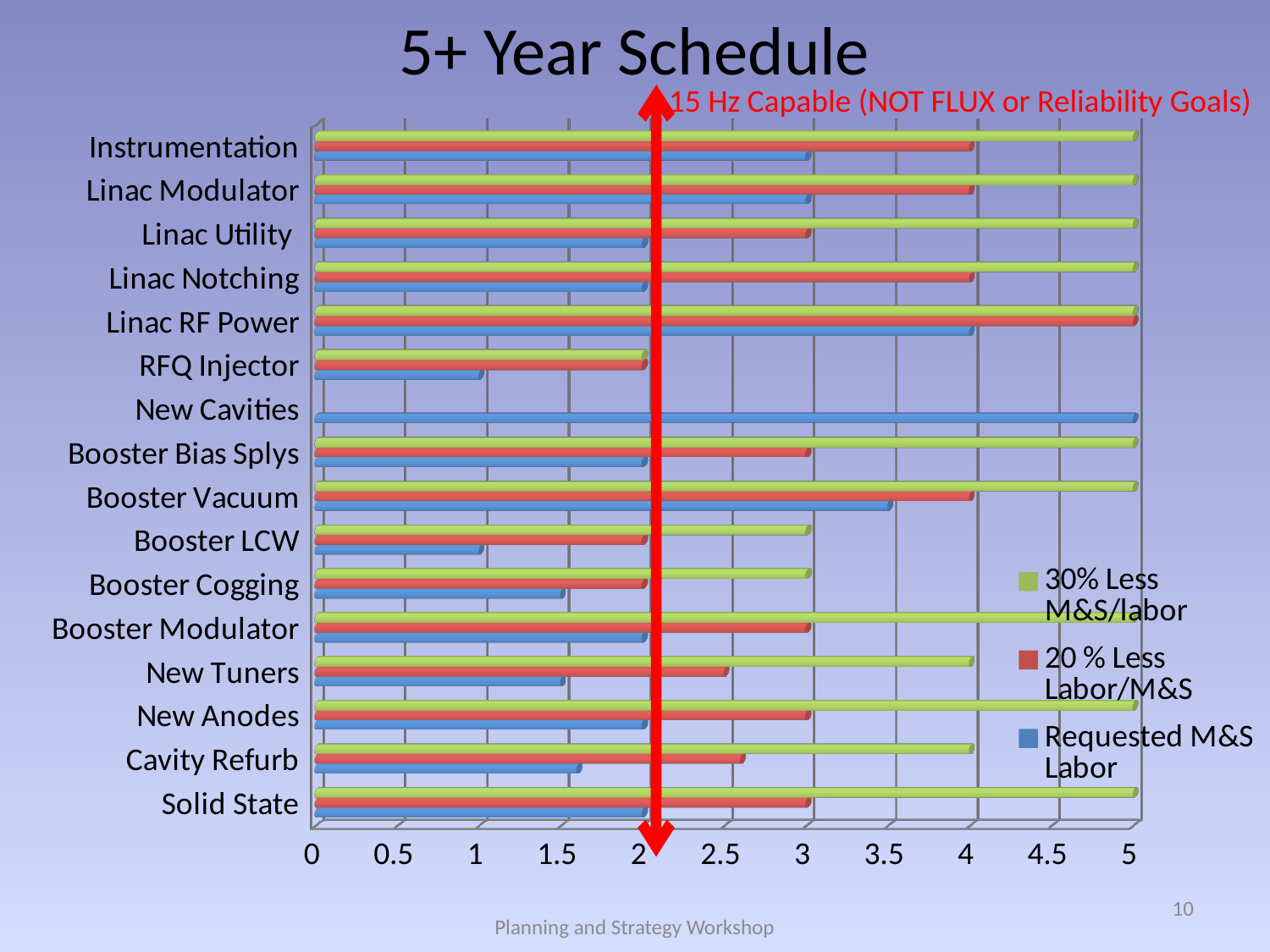
What is the title of the chart on the slide? 5+ Year Schedule What kind of chart is shown on the slide? bar chart How many series does the chart legend list? 3 What is the '30% Less M&S/labor' value for Linac RF Power? 5 Is the 'Requested M&S Labor' value for RFQ Injector greater or less than 1.5? less Which colour represents the 'Requested M&S Labor' series in the legend? blue How many categories are listed on the vertical axis of the chart? 16 Is the '20 % Less Labor/M&S' value for Linac RF Power greater or less than 4.5? greater Is the '30% Less M&S/labor' value for New Tuners greater or less than 4.5? less For Booster Vacuum, which is larger: the '30% Less M&S/labor' value or the 'Requested M&S Labor' value? 30% Less M&S/labor